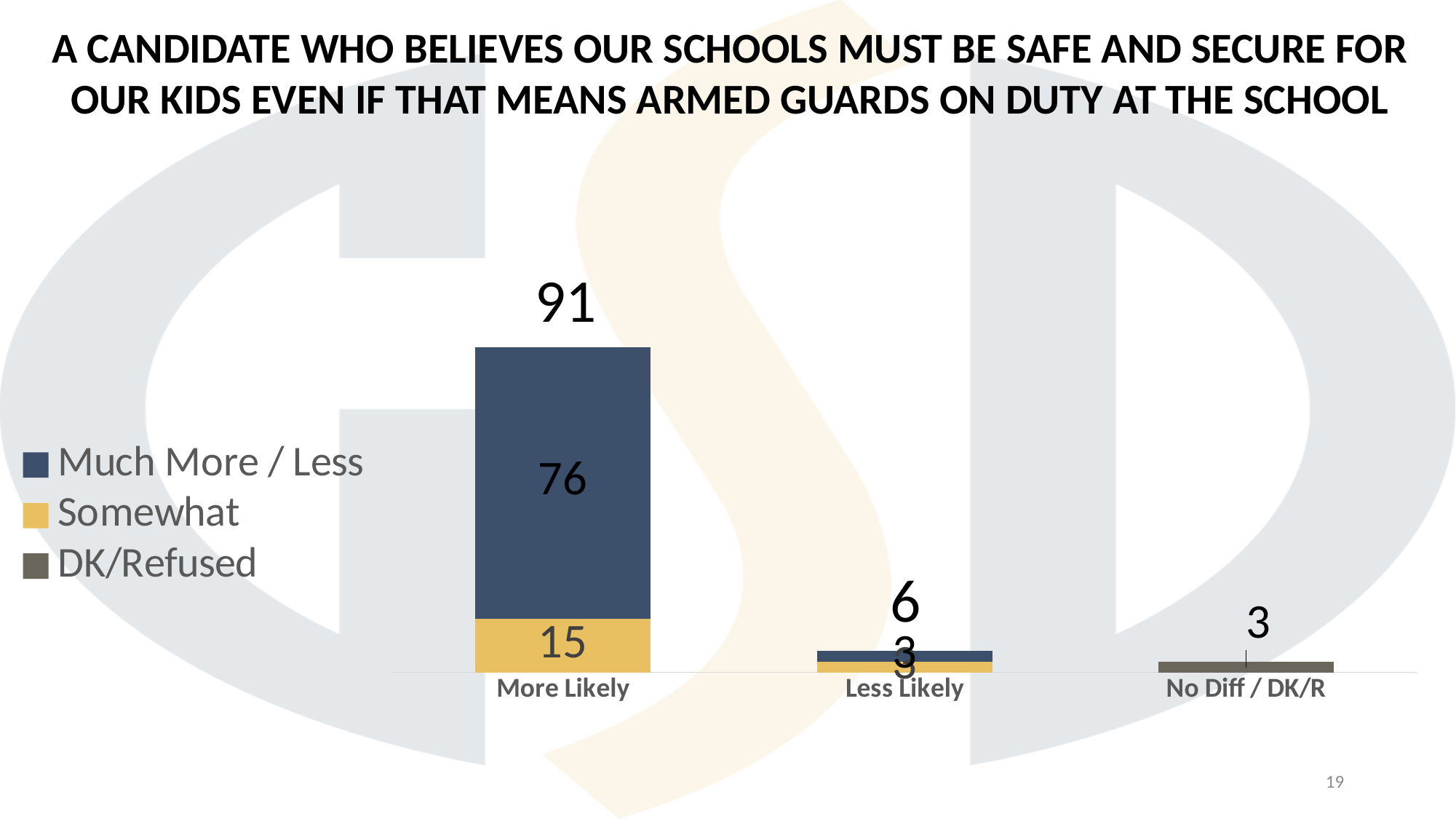
What kind of chart is shown on the slide? Stacked bar chart What is the total value shown above the More Likely bar? 91 How many categories are shown on the x axis? 3 What is the value for No Diff / DK/R? 3 What is the Much More / Less value for More Likely? 76 Which category has the lowest total? No Diff / DK/R What is the difference between the More Likely total and the Less Likely total? 85 How many series does the legend list? 3 What is the total value shown above the Less Likely bar? 6 What is the Somewhat value for More Likely? 15 Which category has the highest total? More Likely Which is larger, the Much More / Less value for More Likely or the Somewhat value for More Likely? Much More / Less